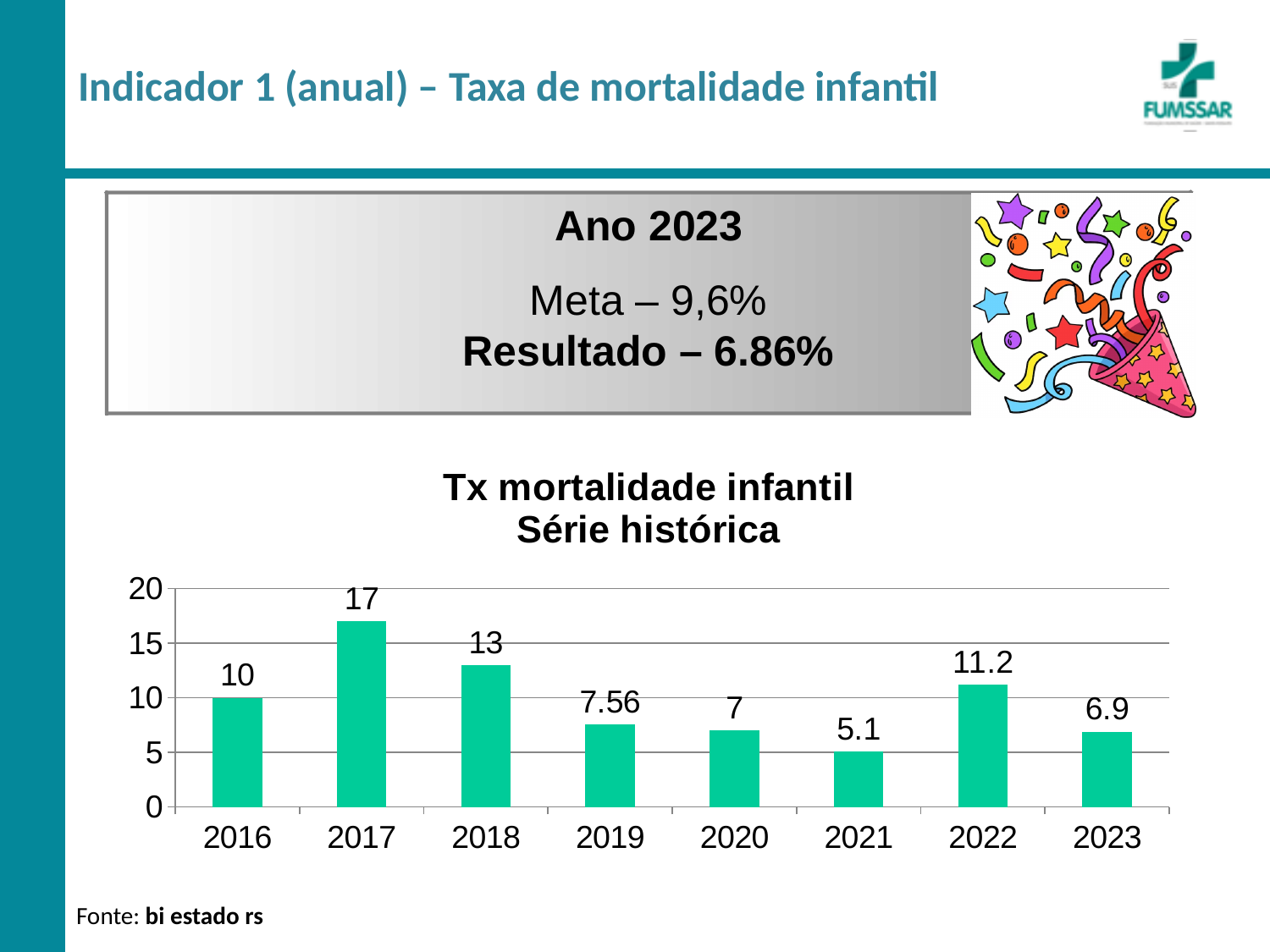
What is the title of the chart? Tx mortalidade infantil Série histórica Which is larger, the value for 2016 or the value for 2020? 2016 What is the value for 2023? 6.9 Is the value for 2021 greater or less than 10? less How many years are shown on the x axis? 8 What kind of chart is shown? bar chart Which year has the highest value? 2017 What is the difference between the values for 2022 and 2023? 4.3 What is the value for 2019? 7.56 What is the difference between the values for 2017 and 2018? 4 Which year has the lowest value? 2021 What is the value for 2022? 11.2